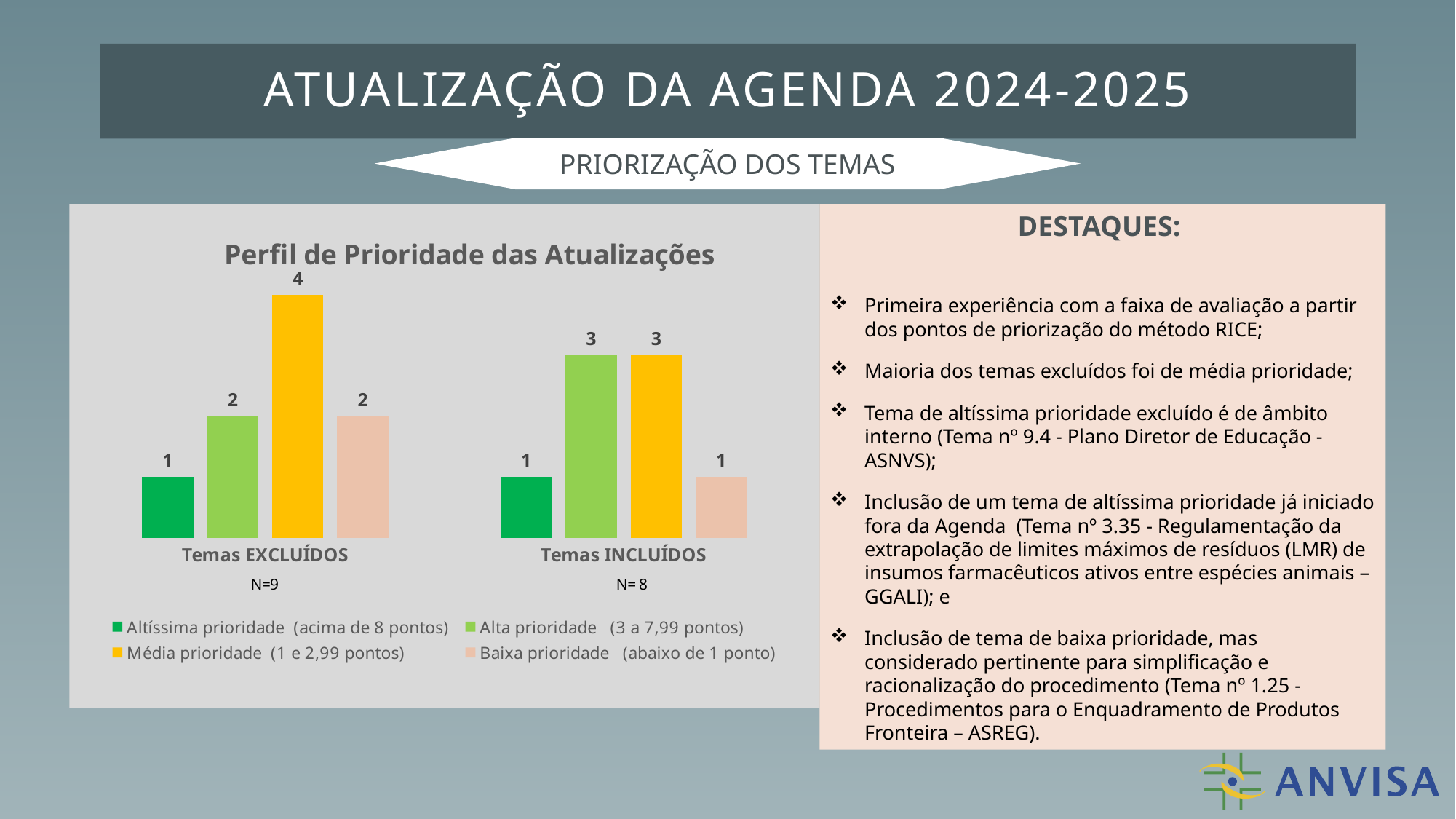
What is the value for Baixa prioridade in the Temas INCLUÍDOS category? 1 How many categories are shown on the x axis of the chart? 2 What is the N value shown under Temas EXCLUÍDOS? N=9 What is the value for Média prioridade in the Temas EXCLUÍDOS category? 4 Which is larger: Alta prioridade for Temas EXCLUÍDOS or Alta prioridade for Temas INCLUÍDOS? Temas INCLUÍDOS How many series does the chart legend list? 4 What is the difference between the Média prioridade values for Temas EXCLUÍDOS and Temas INCLUÍDOS? 1 Which priority series has the lowest value in the Temas EXCLUÍDOS category? Altíssima prioridade Which priority series has the highest value in the Temas EXCLUÍDOS category? Média prioridade What kind of chart is shown on the slide? Bar chart What is the title of the chart? Perfil de Prioridade das Atualizações What is the value for Alta prioridade in the Temas INCLUÍDOS category? 3